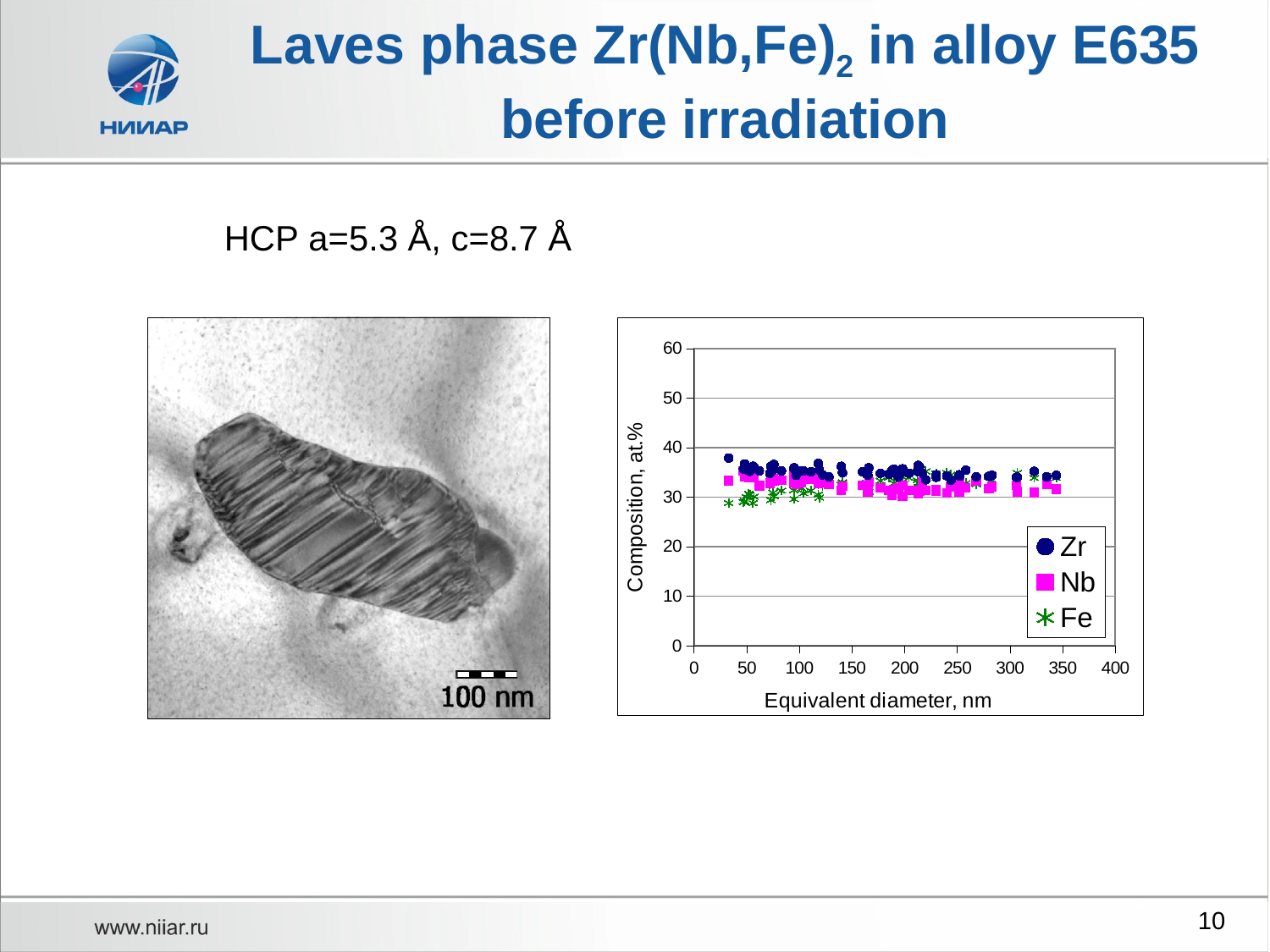
Which series has the lowest composition values at equivalent diameters below 100 nm? Fe At an equivalent diameter of about 50 nm, which is larger, the Zr value or the Fe value? Zr Are the Zr composition values greater or less than 40 at.%? less What is the label of the chart's x axis? Equivalent diameter, nm Which series has the highest composition values across the plotted diameters? Zr Do the Zr composition values rise, fall, or stay roughly flat as equivalent diameter increases? roughly flat What is the maximum value shown on the chart's x axis? 400 Are the Nb composition values greater or less than 20 at.%? greater How many series does the chart legend list? 3 What kind of chart is shown on the slide? scatter chart Are the Zr composition values greater or less than 30 at.%? greater Which elements are listed in the chart legend? Zr, Nb, Fe